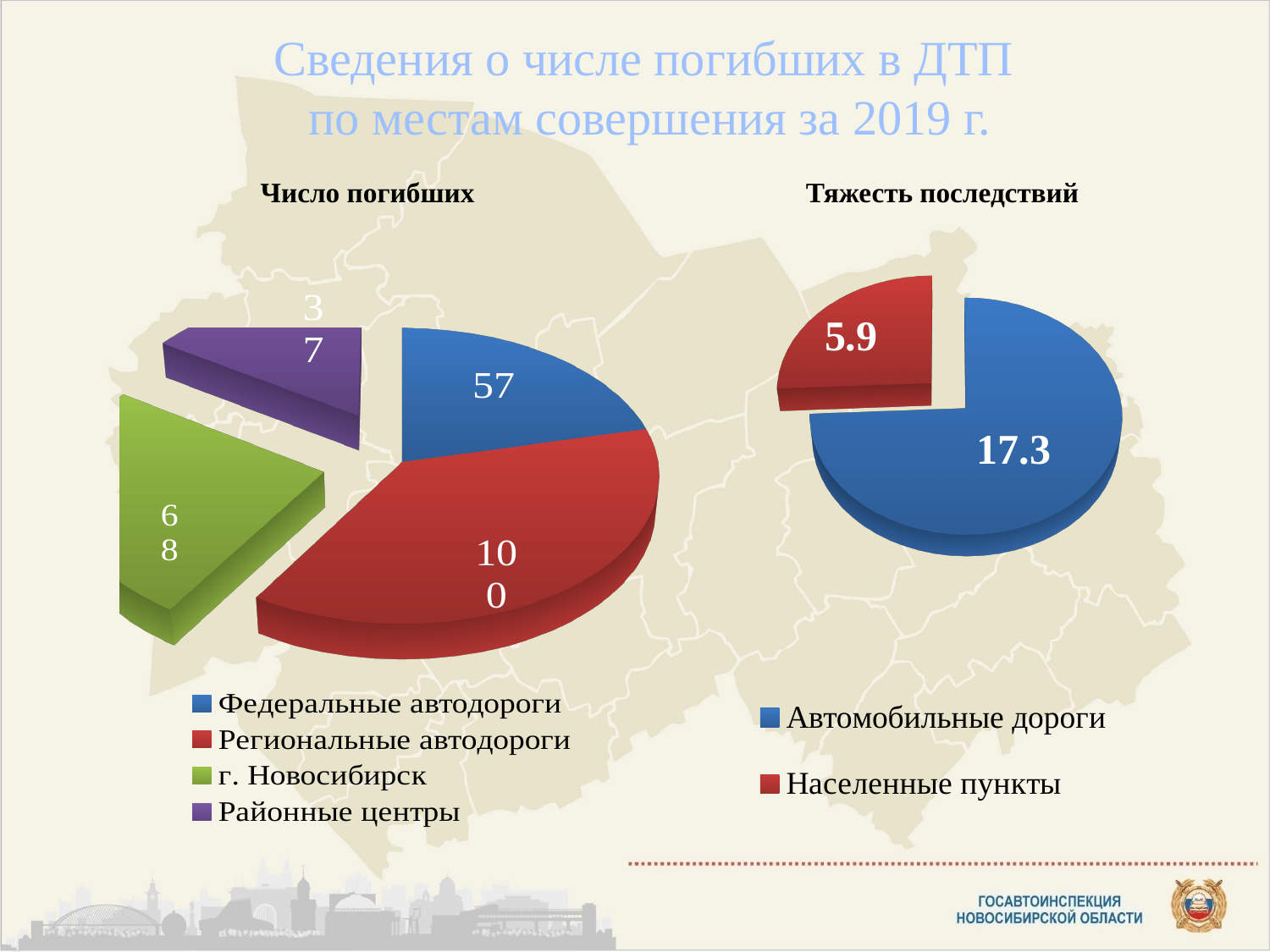
In the chart titled "Тяжесть последствий", which is larger: Автомобильные дороги or Населенные пункты? Автомобильные дороги In the chart titled "Число погибших", how many categories are shown? 4 In the chart titled "Число погибших", which category has the highest value? Региональные автодороги In the chart titled "Число погибших", what is the value for г. Новосибирск? 68 What kind of chart is the chart titled "Тяжесть последствий"? Pie chart In the chart titled "Число погибших", what is the value for Региональные автодороги? 100 In the chart titled "Число погибших", what is the difference between the values for Региональные автодороги and Федеральные автодороги? 43 In the chart titled "Число погибших", which category has the lowest value? Районные центры In the chart titled "Число погибших", what colour is the slice for г. Новосибирск? Green In the chart titled "Тяжесть последствий", what is the value for Автомобильные дороги? 17.3 In the chart titled "Тяжесть последствий", what is the value for Населенные пункты? 5.9 In the chart titled "Число погибших", what is the value for Районные центры? 37